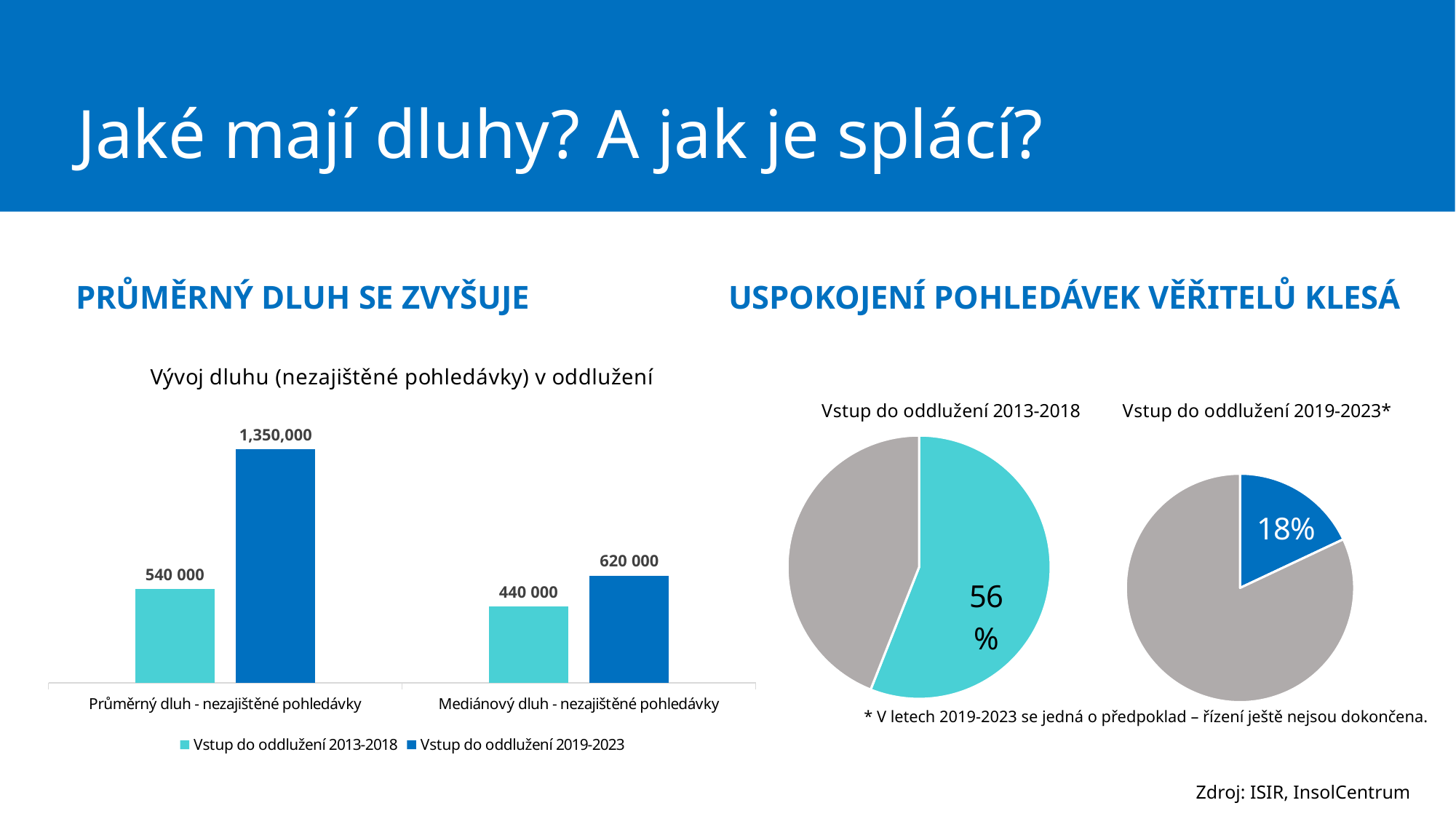
In the bar chart 'Vývoj dluhu (nezajištěné pohledávky) v oddlužení', how many categories are shown on the x axis? 2 In the pie chart 'Vstup do oddlužení 2013-2018', what share is shown for the labelled (turquoise) slice? 56% What kind of chart is 'Vývoj dluhu (nezajištěné pohledávky) v oddlužení'? bar chart In the bar chart 'Vývoj dluhu (nezajištěné pohledávky) v oddlužení', what is the difference between the two series for 'Průměrný dluh - nezajištěné pohledávky'? 810 000 In the bar chart 'Vývoj dluhu (nezajištěné pohledávky) v oddlužení', what is the difference between the two series for 'Mediánový dluh - nezajištěné pohledávky'? 180 000 In the bar chart 'Vývoj dluhu (nezajištěné pohledávky) v oddlužení', which bar has the highest value? Průměrný dluh - nezajištěné pohledávky, Vstup do oddlužení 2019-2023 In the bar chart 'Vývoj dluhu (nezajištěné pohledávky) v oddlužení', what is the value for 'Průměrný dluh - nezajištěné pohledávky' for the series 'Vstup do oddlužení 2013-2018'? 540 000 In the bar chart 'Vývoj dluhu (nezajištěné pohledávky) v oddlužení', how many series does the legend list? 2 In the pie chart 'Vstup do oddlužení 2019-2023*', what share is shown for the labelled (blue) slice? 18% In the bar chart 'Vývoj dluhu (nezajištěné pohledávky) v oddlužení', which bar has the lowest value? Mediánový dluh - nezajištěné pohledávky, Vstup do oddlužení 2013-2018 In the bar chart 'Vývoj dluhu (nezajištěné pohledávky) v oddlužení', what is the value for 'Průměrný dluh - nezajištěné pohledávky' for the series 'Vstup do oddlužení 2019-2023'? 1,350,000 In the bar chart 'Vývoj dluhu (nezajištěné pohledávky) v oddlužení', what is the value for 'Mediánový dluh - nezajištěné pohledávky' for the series 'Vstup do oddlužení 2013-2018'? 440 000